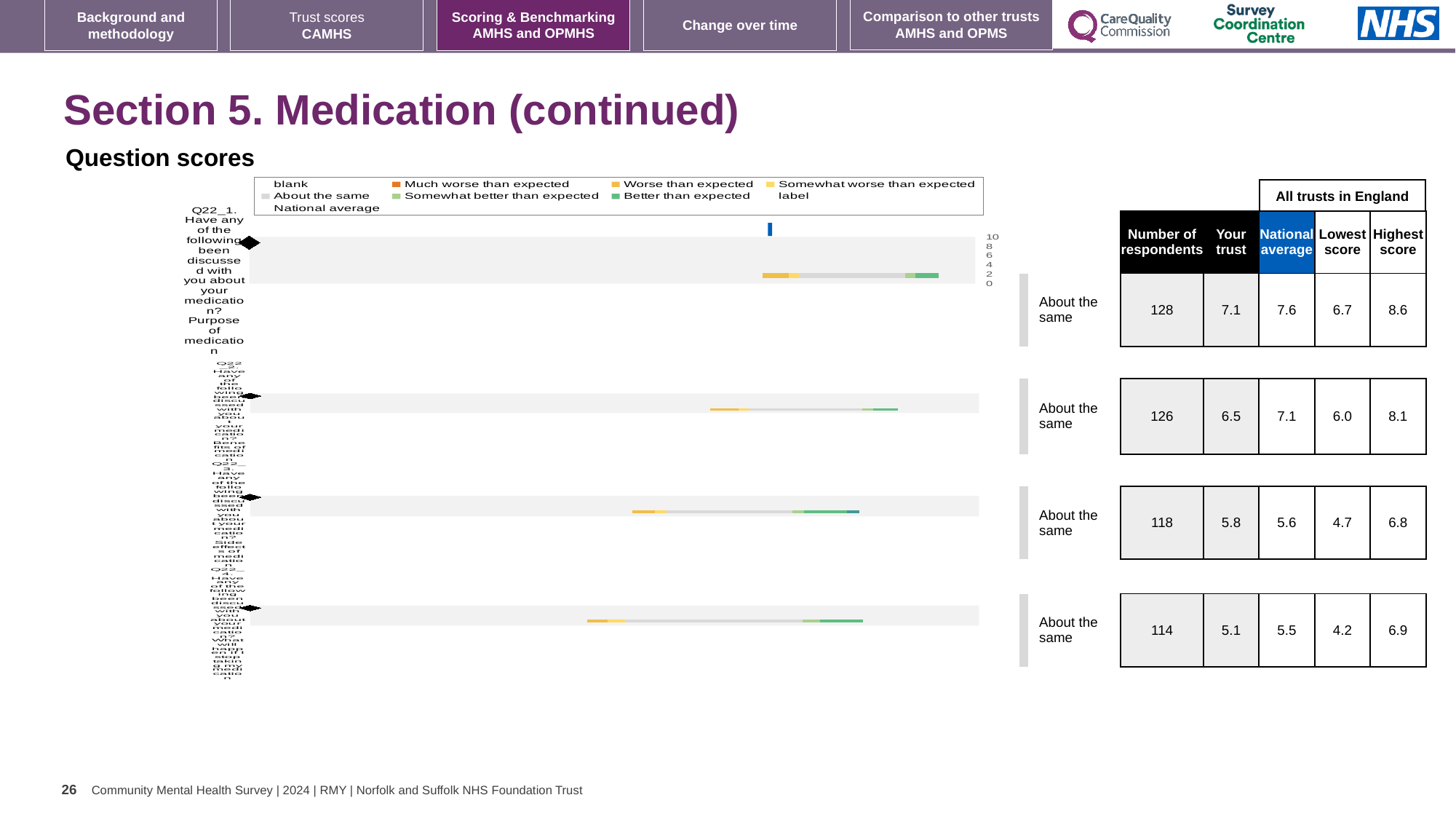
What kind of chart is shown on the slide? bar chart What is the national average score for Q22_1 (Purpose of medication)? 7.6 Which question row has the most respondents? Q22_1 (Purpose of medication) For Q22_1, which is larger: the 'Your trust' score or the national average? national average What is the highest score among all trusts in England for the first question row (Q22_1)? 8.6 What is the lowest score among all trusts in England for the fourth question row (Q22_4)? 4.2 What benchmark category is shown for every question row in the chart? About the same How many respondents answered Q22_1 (Purpose of medication)? 128 How many question rows (bars) are plotted in the chart? 4 Which question row has the fewest respondents? Q22_4 (the fourth row) What is the 'Your trust' score for Q22_1 (Purpose of medication)? 7.1 What is the difference between the national average and the 'Your trust' score for Q22_1? 0.5